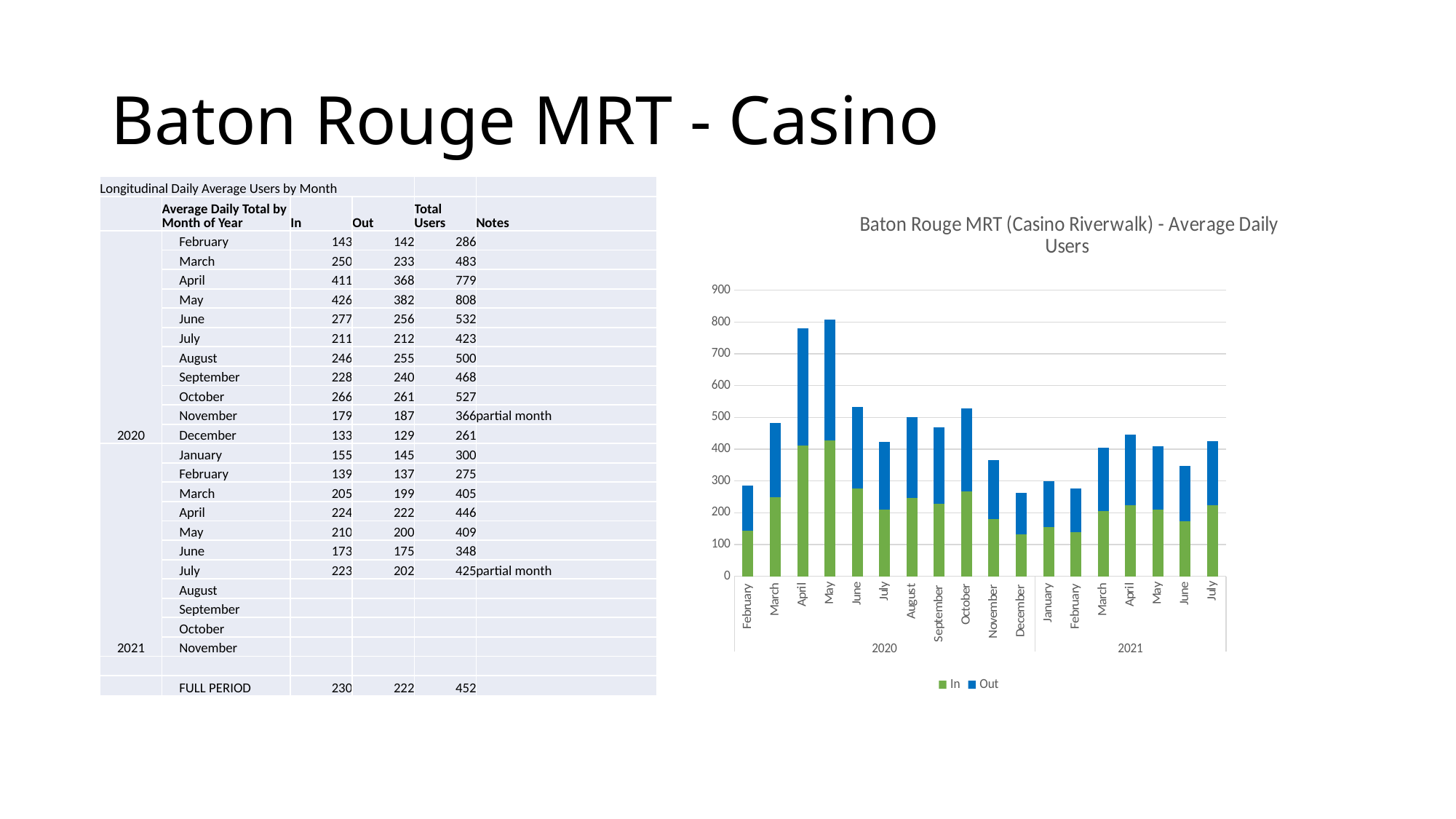
Which is larger, the total for October 2020 or the total for August 2020? October 2020 What kind of chart is shown on the slide? stacked bar chart What is the difference between the total users for May 2020 and April 2020? 29 Is the total value for April 2020 greater or less than 700? greater Which colour represents the 'Out' series in the chart? blue What is the 'In' value for April 2020? 411 Which month has the highest total average daily users in the chart? May 2020 Which month has the lowest total average daily users in the chart? December 2020 How many series does the chart legend list? 2 How many monthly bars are plotted in the chart? 18 What is the total average daily users for May 2020? 808 Is the total value for November 2020 greater or less than 400? less